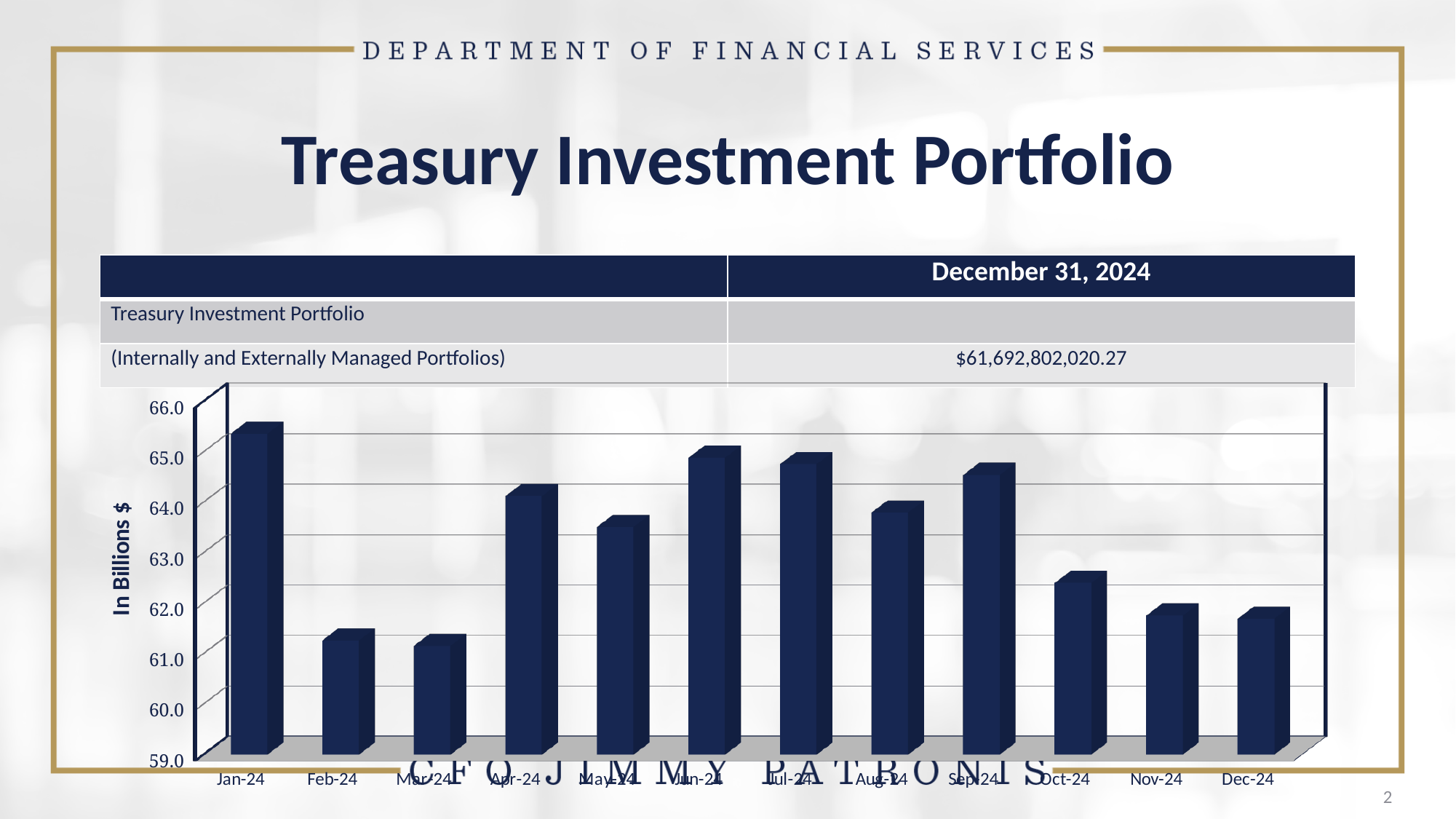
Is the value for Feb-24 greater or less than 62.0? less Which is larger, the value for Jun-24 or the value for Dec-24? Jun-24 Is the value for Oct-24 greater or less than 63.0? less Is the value for Jan-24 greater or less than 65.0? greater What is the label on the vertical axis of the chart? In Billions $ What kind of chart is shown on the slide? bar chart Which is larger, the value for Apr-24 or the value for Feb-24? Apr-24 Do the values rise or fall from Sep-24 to Dec-24? fall How many months are plotted on the chart? 12 Which month has the highest value on the chart? Jan-24